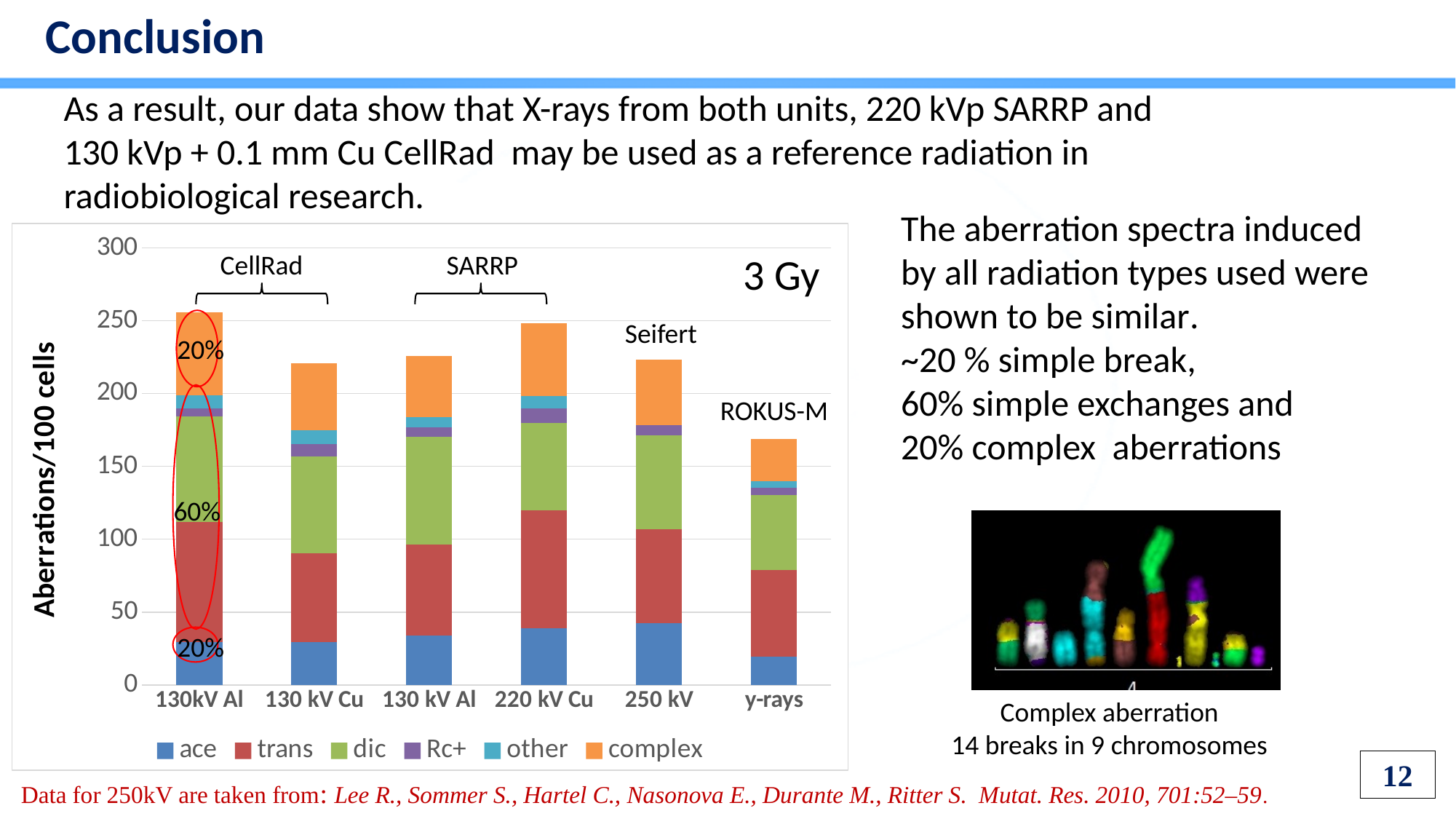
What is the label of the y axis of the chart? Aberrations/100 cells Which has a larger total, 250 kV or y-rays? 250 kV Which legend entry is shown in orange? complex Is the total value for y-rays greater or less than 150? greater How many categories are shown along the x axis of the chart? 6 Is the total value for 130 kV Cu greater or less than 250? less How many series does the chart's legend list? 6 What kind of chart is shown on the slide? stacked bar chart Is the total value for 220 kV Cu greater or less than 200? greater Which category has the lowest total aberrations per 100 cells? y-rays Which has a larger total, 130 kV Cu or 220 kV Cu? 220 kV Cu